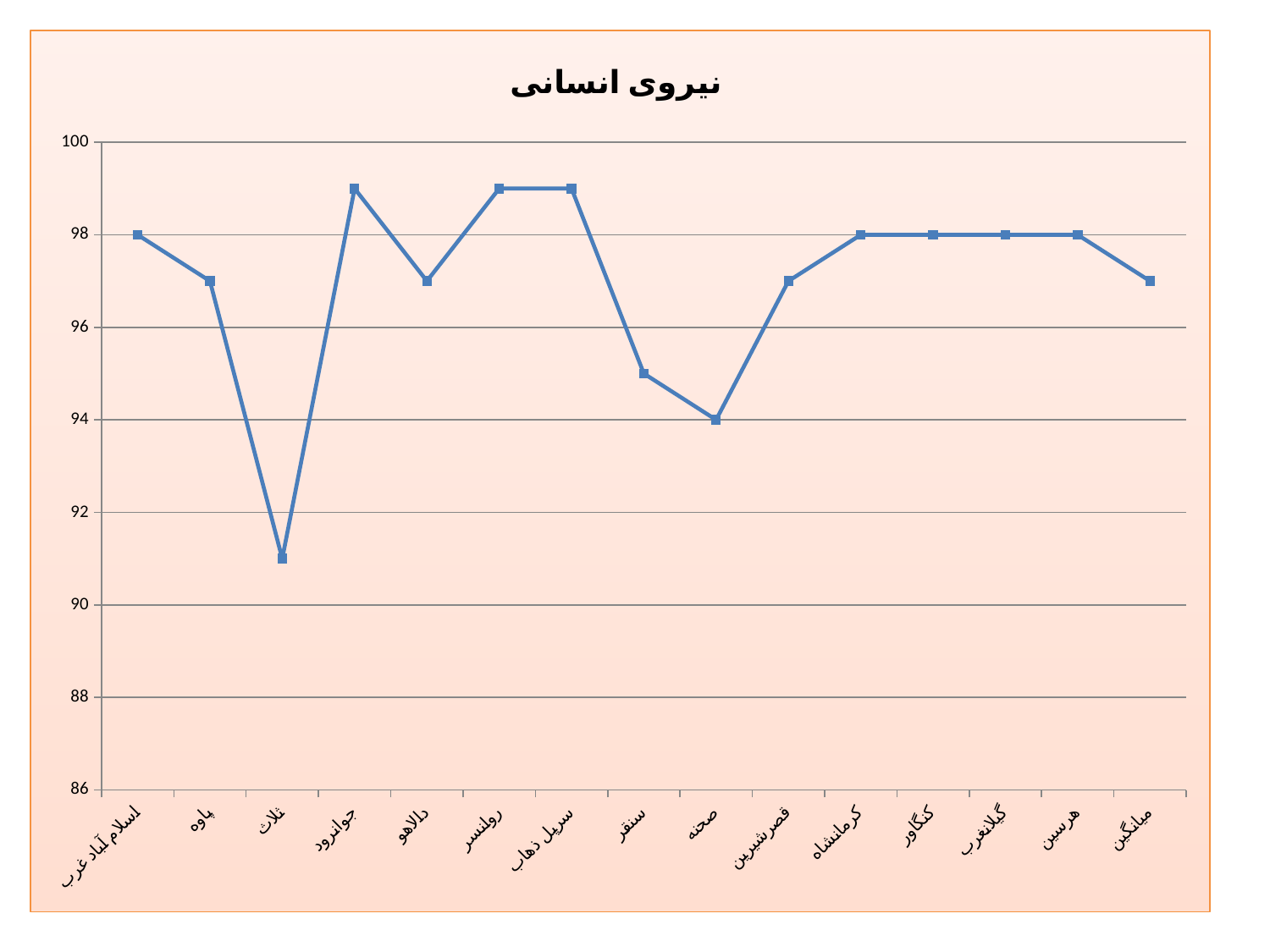
Is the value for سنقر greater or less than 96? less What is the value for صحنه? 94 Which is larger, the value for پاوه or the value for ثلاث? پاوه What kind of chart is shown on the slide? line chart What is the title of the chart? نیروی انسانی What is the difference between the values for اسلام آباد غرب and صحنه? 4 What is the value for کرمانشاه? 98 How many categories are plotted along the x axis? 15 Which category has the lowest value? ثلاث Is the value for ثلاث greater or less than 92? less What is the value for اسلام آباد غرب? 98 Is the value for جوانرود greater or less than 98? greater